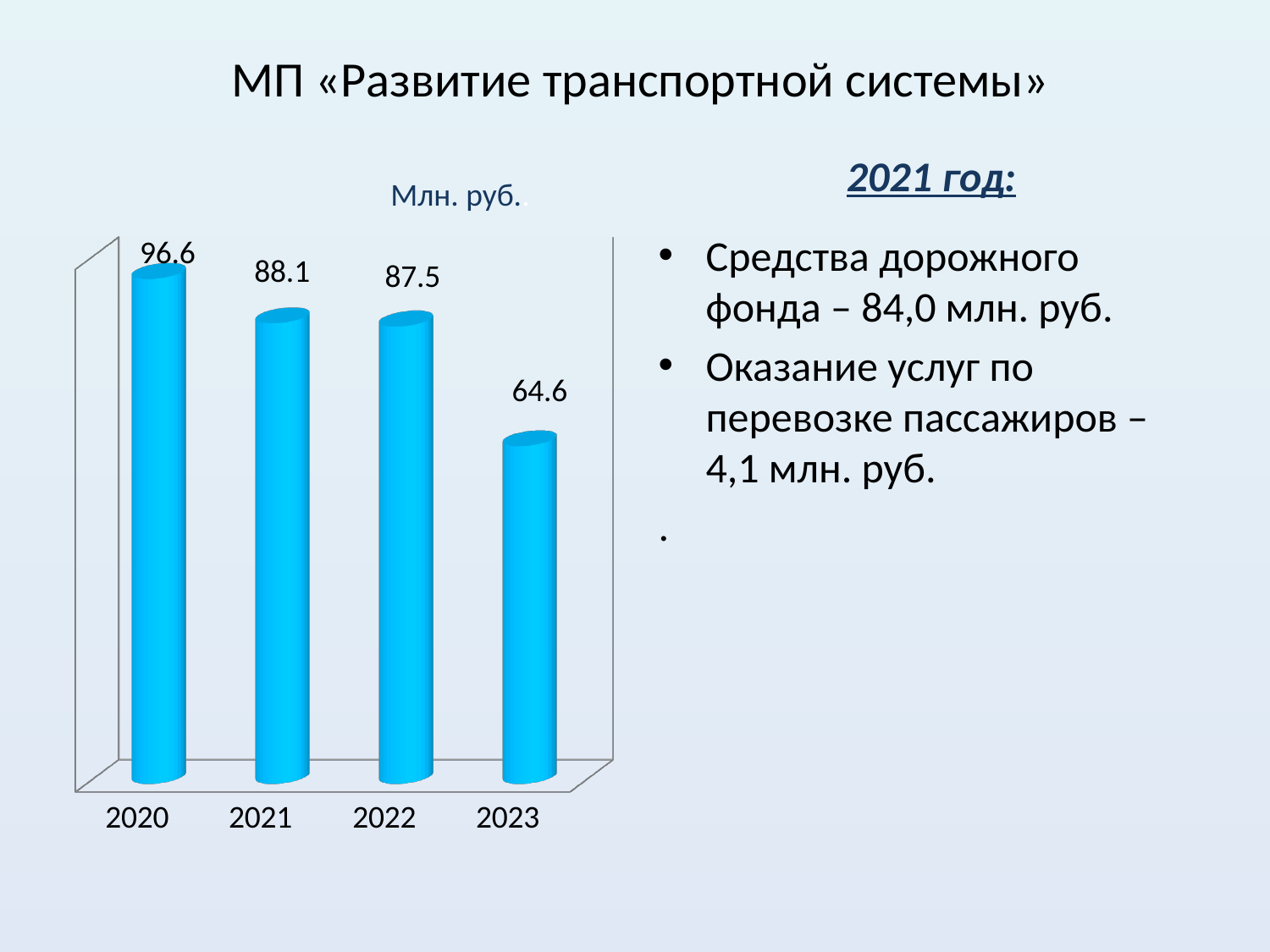
What is the value for 2020? 96.6 What is the value for 2023? 64.6 What is the difference between the values for 2021 and 2022? 0.6 Do the values rise or fall from 2020 to 2023? fall Which year has the lowest value? 2023 Which is larger, the value for 2020 or the value for 2021? 2020 What is the value for 2021? 88.1 Which year has the highest value? 2020 What is the value for 2022? 87.5 What kind of chart is shown on the slide? bar chart How many years are shown on the chart? 4 What is the difference between the values for 2020 and 2023? 32.0